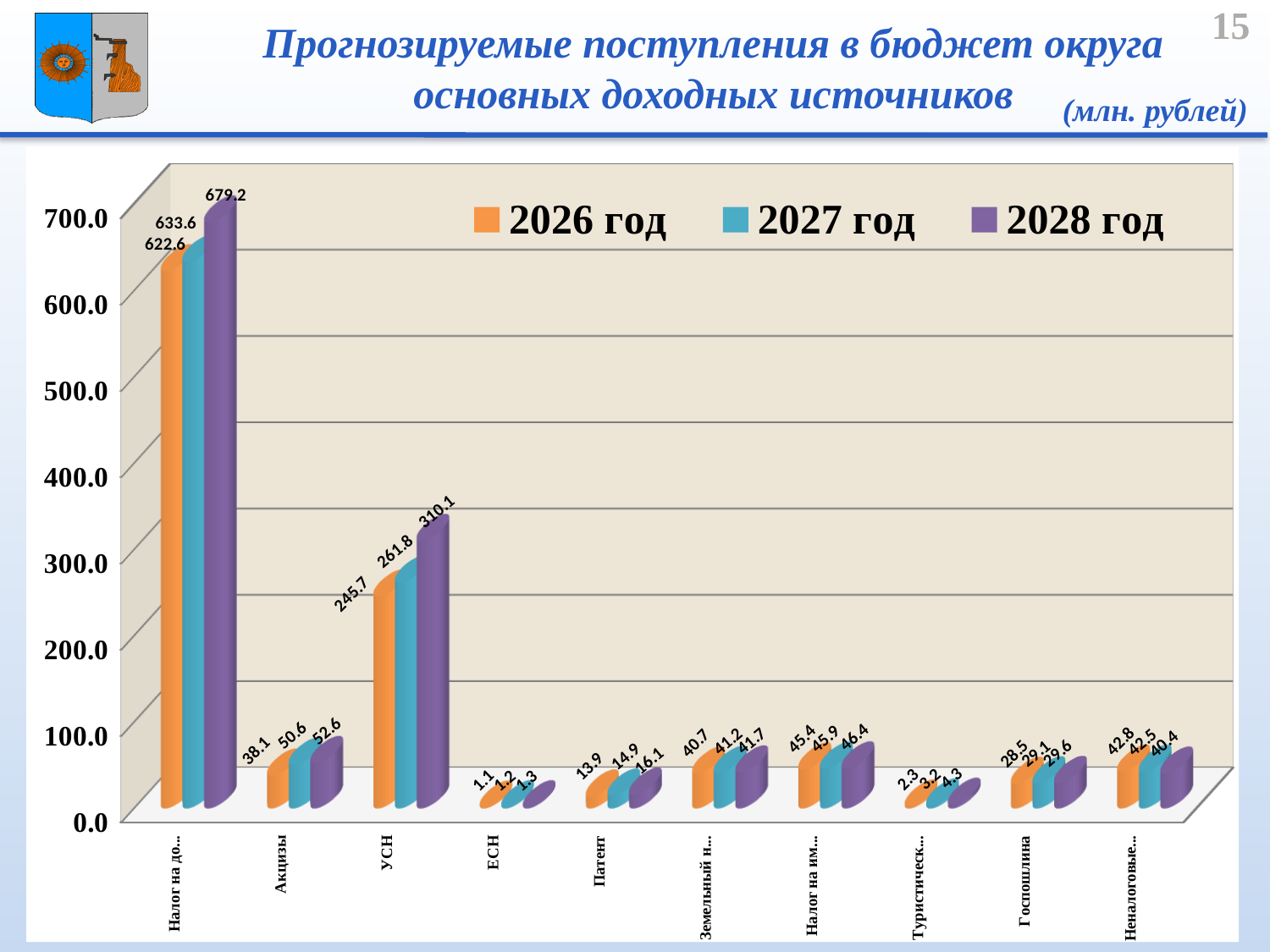
Is the 2026 год value for УСН greater or less than 200.0? greater What kind of chart is shown on the slide? Bar chart What is the value for Патент in the 2028 год series? 16.1 Which is larger: the 2028 год value for Акцизы or the 2028 год value for Госпошлина? Акцизы Which category has the lowest value in the 2026 год series? ЕСН What is the value for Акцизы in the 2026 год series? 38.1 What is the value for УСН in the 2028 год series? 310.1 How many series does the legend list? 3 What is the difference between the 2027 год and 2026 год values for Акцизы? 12.5 What is the difference between the 2028 год and 2026 год values for УСН? 64.4 What is the value for Госпошлина in the 2027 год series? 29.1 Do the values for УСН rise or fall from 2026 год to 2028 год? Rise